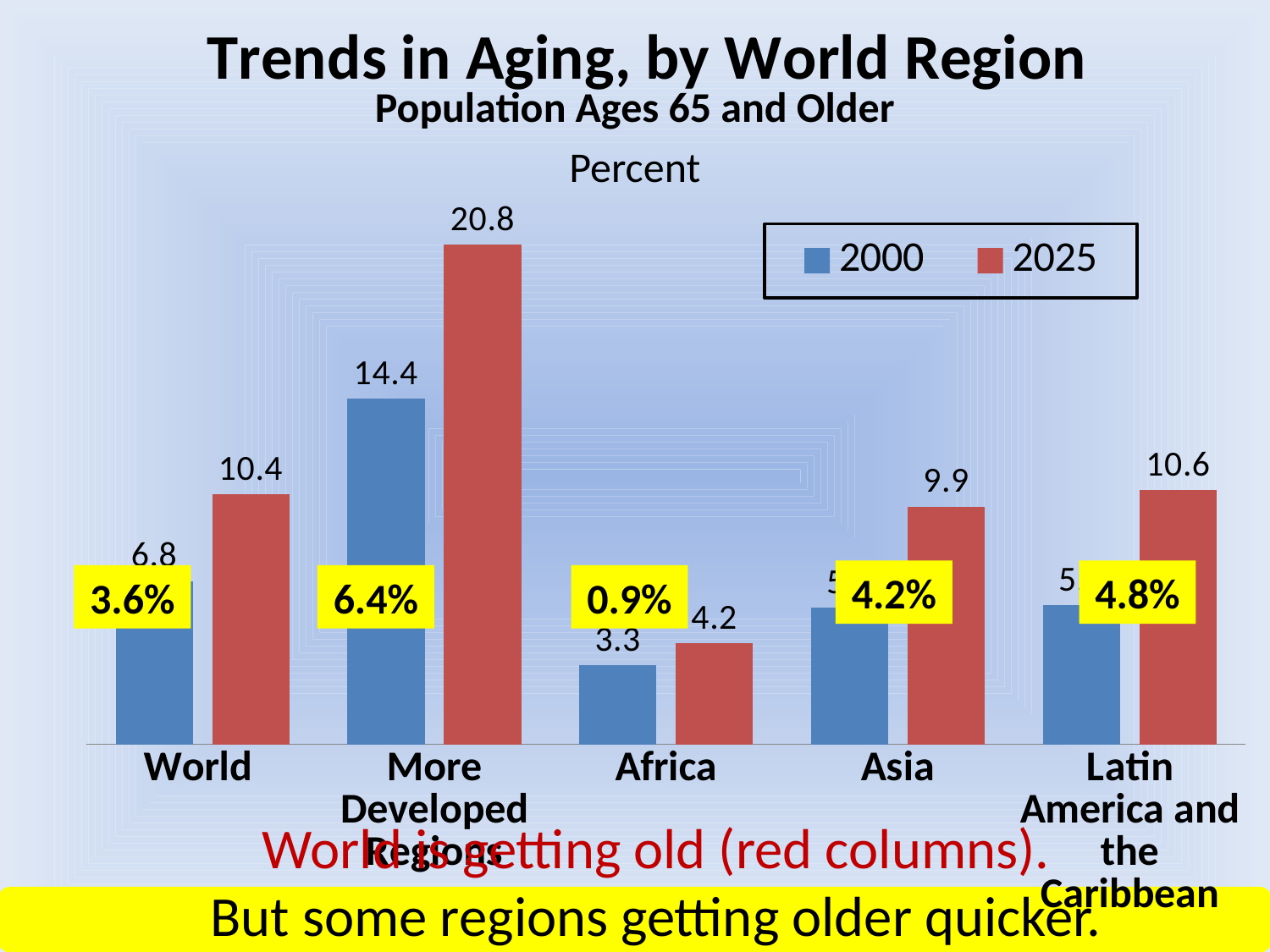
By how much does the World value increase from 2000 to 2025? 3.6 What is the 2025 value for Asia? 9.9 Which region has the highest 2025 value? More Developed Regions How many regions are shown on the x axis? 5 How many series does the legend list? 2 What is the 2025 value for More Developed Regions? 20.8 Which region has the lowest 2025 value? Africa What kind of chart is shown on the slide? Bar chart What is the 2025 value for Africa? 4.2 What is the 2000 value for World? 6.8 Which has the larger 2025 value, Asia or Latin America and the Caribbean? Latin America and the Caribbean What are the two series named in the legend? 2000 and 2025